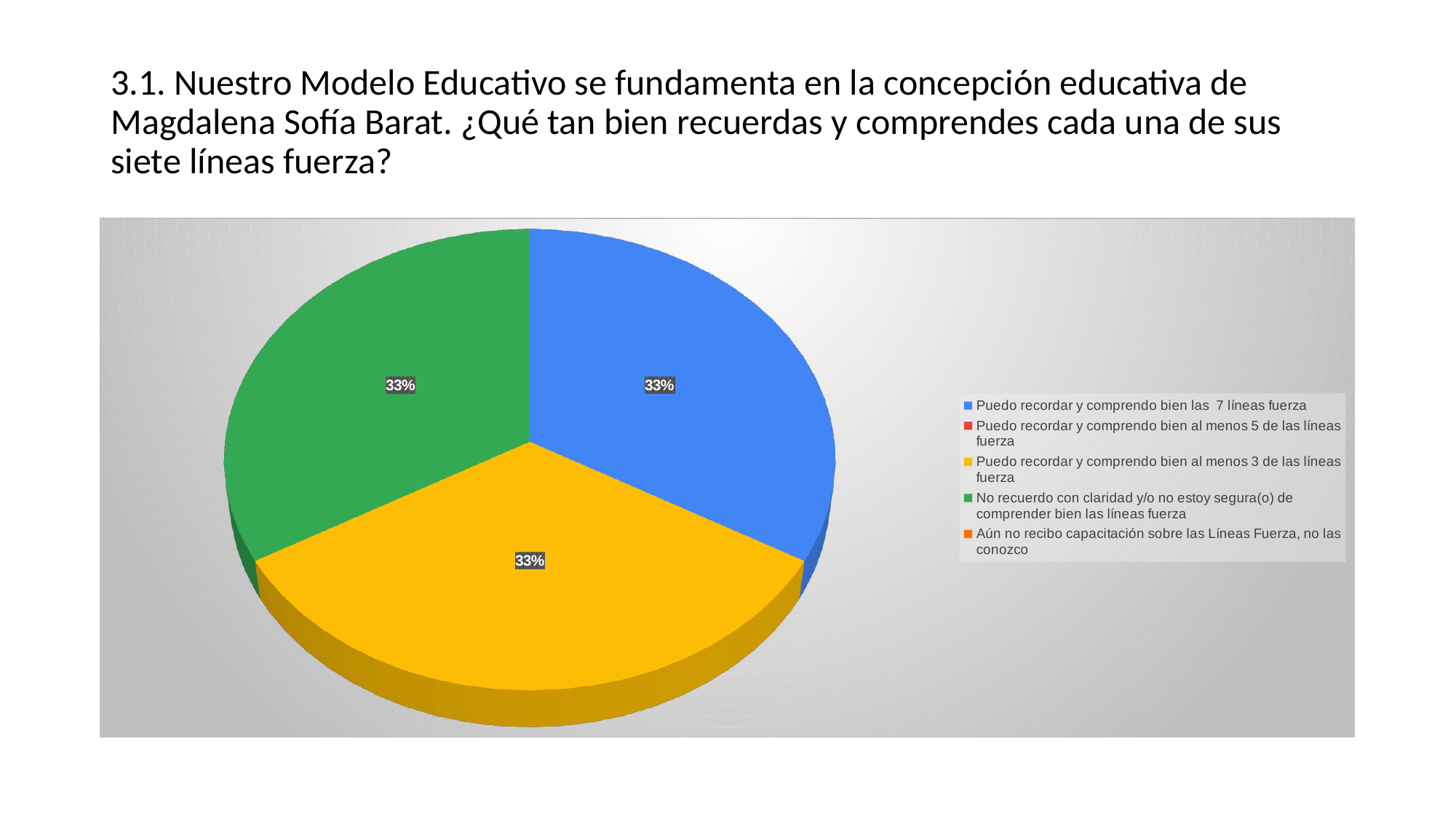
What percentage is shown for the slice "Puedo recordar y comprendo bien al menos 3 de las líneas fuerza"? 33% Which colour represents "No recuerdo con claridad y/o no estoy segura(o) de comprender bien las líneas fuerza" in the legend? green Which legend entry is represented by the yellow slice? Puedo recordar y comprendo bien al menos 3 de las líneas fuerza What share of the pie does the yellow slice represent? 33% What percentage is shown for the slice "Puedo recordar y comprendo bien las 7 líneas fuerza"? 33% How many entries does the legend list? 5 What kind of chart is shown on the slide? pie chart How many slices with data labels are visible in the pie? 3 What is the difference between the percentage of the blue slice and the percentage of the green slice? 0% What percentage is shown for the slice "No recuerdo con claridad y/o no estoy segura(o) de comprender bien las líneas fuerza"? 33% What share of the pie does the blue slice represent? 33%